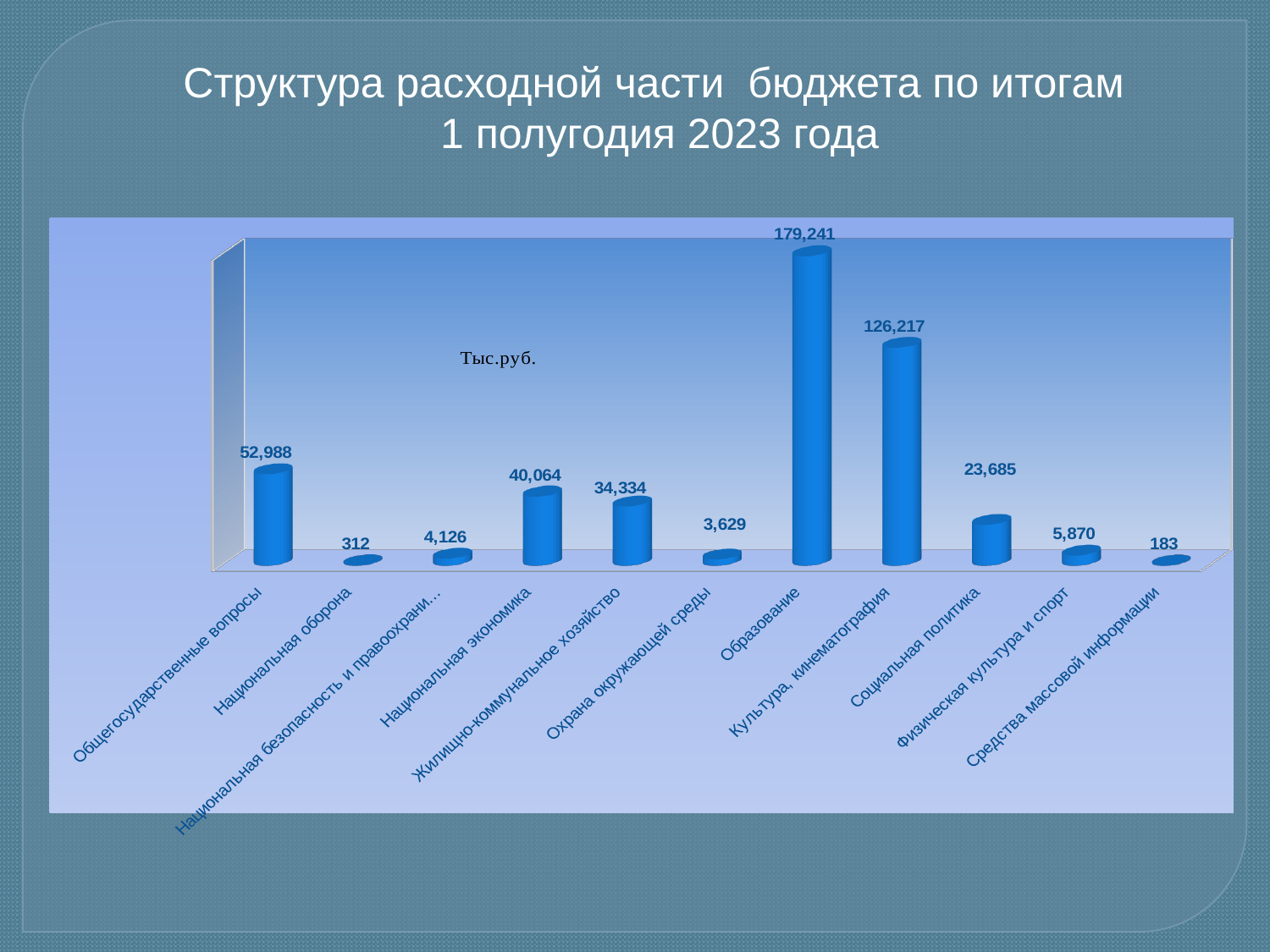
What is the value for Средства массовой информации? 183 Which is larger, the value for Жилищно-коммунальное хозяйство or the value for Социальная политика? Жилищно-коммунальное хозяйство What unit is indicated on the chart? Тыс.руб. What kind of chart is shown on the slide? Bar chart What is the difference between the values for Образование and Культура, кинематография? 53,024 Which category has the lowest value? Средства массовой информации What is the value for Образование? 179,241 Which category has the highest value? Образование What is the value for Национальная экономика? 40,064 How many categories are shown in the chart? 11 What is the value for Культура, кинематография? 126,217 What is the difference between the values for Общегосударственные вопросы and Национальная экономика? 12,924